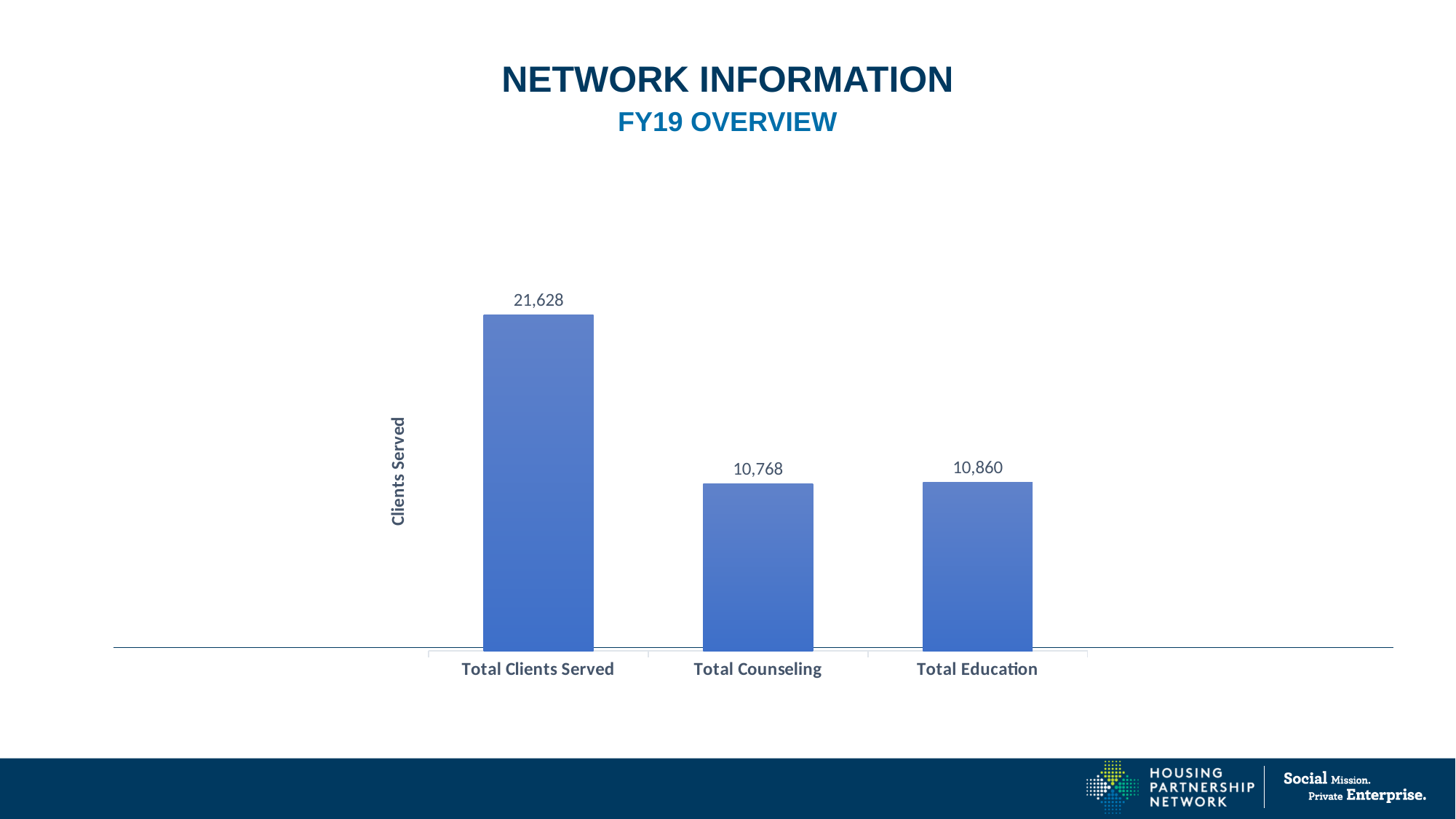
What is the value for Total Education? 10,860 What is the value for Total Counseling? 10,768 What kind of chart is shown on the slide? Bar chart What is the subtitle shown below the slide title? FY19 OVERVIEW How many categories are shown in the chart? 3 What is the label of the vertical axis? Clients Served What is the value for Total Clients Served? 21,628 Which is larger, Total Clients Served or Total Education? Total Clients Served What is the difference between Total Clients Served and Total Counseling? 10,860 What is the difference between Total Education and Total Counseling? 92 Which category has the highest value? Total Clients Served